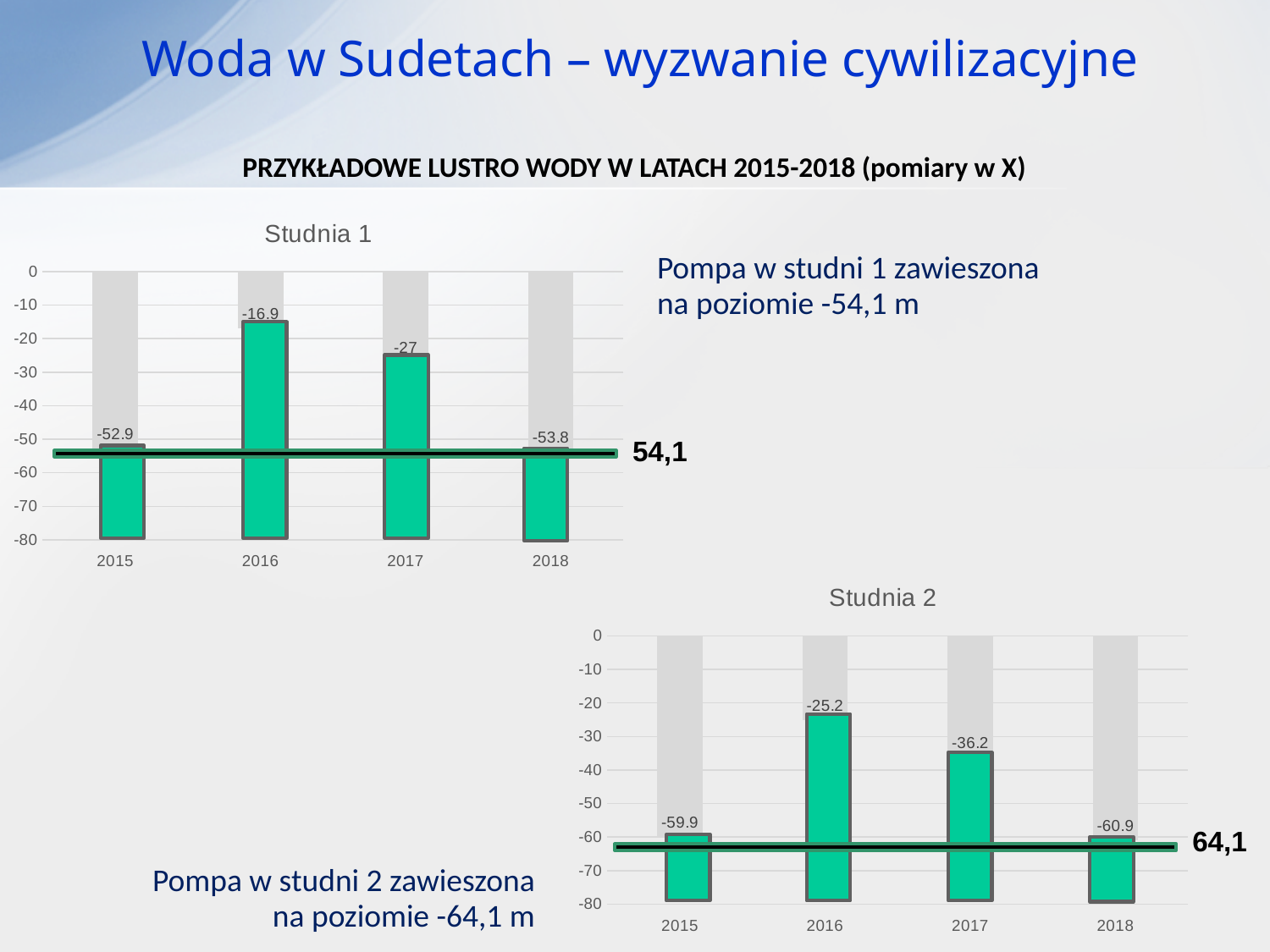
In the Studnia 2 chart, what is the difference between the values for 2016 and 2017? 11 In the Studnia 1 chart, what is the difference between the values for 2016 and 2017? 10.1 What kind of chart is the Studnia 2 chart? bar chart In the Studnia 1 chart, what is the value for 2016? -16.9 In the Studnia 1 chart, what is the value for 2018? -53.8 What is the title of the chart at the bottom right of the slide? Studnia 2 In the Studnia 2 chart, what is the value for 2017? -36.2 How many years are shown in the Studnia 1 chart? 4 In the Studnia 1 chart, which year has the highest value? 2016 In the Studnia 2 chart, which year has the lowest value? 2018 In the Studnia 2 chart, which is larger, the value for 2016 or the value for 2017? 2016 In the Studnia 2 chart, what is the value for 2015? -59.9